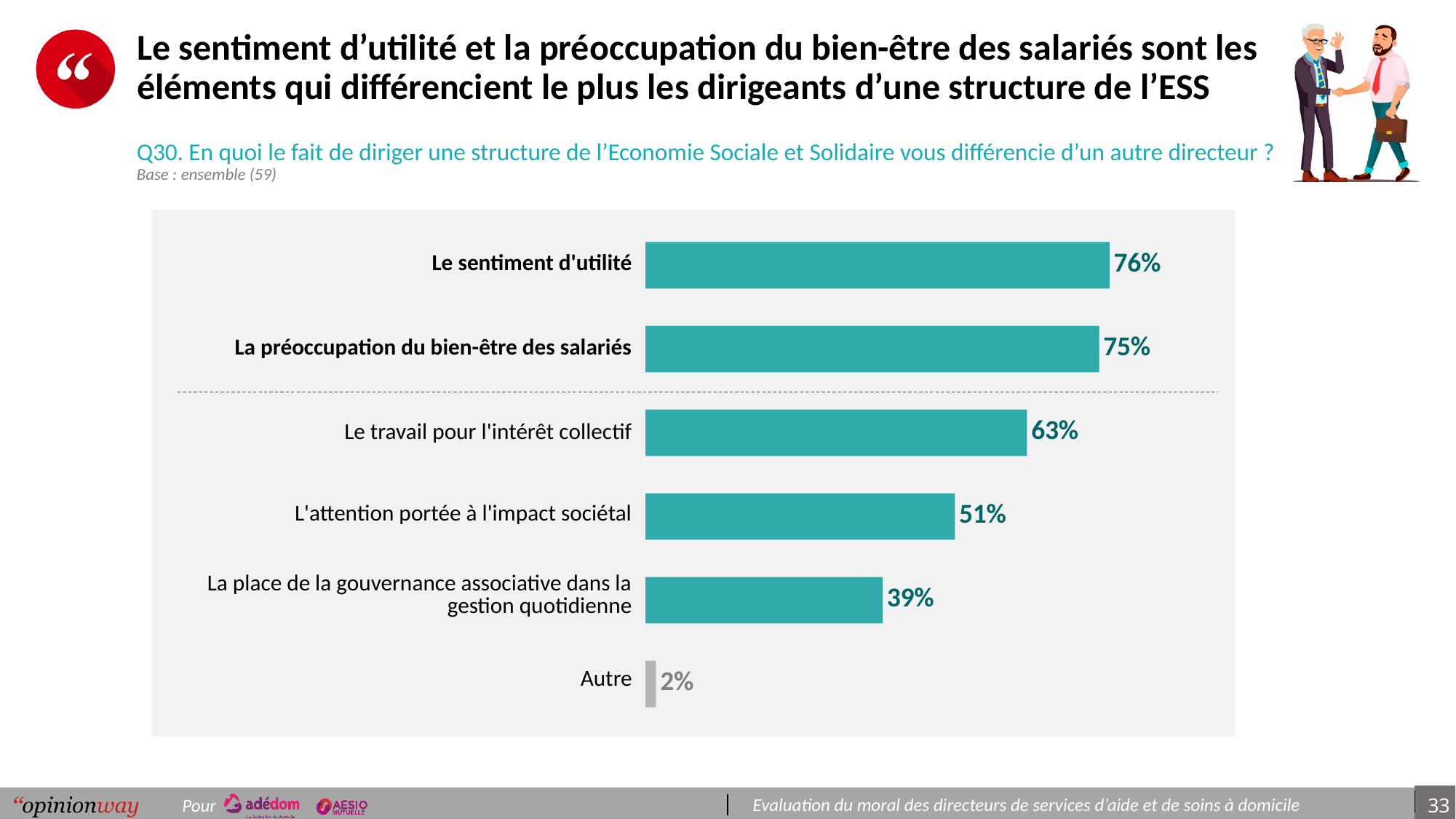
How many categories are shown in the chart? 6 What is the value for "La préoccupation du bien-être des salariés"? 75% What is the value for "Autre"? 2% What is the value for "L'attention portée à l'impact sociétal"? 51% Which is larger: "L'attention portée à l'impact sociétal" or "La place de la gouvernance associative dans la gestion quotidienne"? L'attention portée à l'impact sociétal What is the value for "Le sentiment d'utilité"? 76% What is the difference between "Le travail pour l'intérêt collectif" and "L'attention portée à l'impact sociétal"? 12% What is the value for "Le travail pour l'intérêt collectif"? 63% Which category has the highest value? Le sentiment d'utilité What kind of chart is shown on the slide? Bar chart What is the value for "La place de la gouvernance associative dans la gestion quotidienne"? 39% Which category has the lowest value? Autre